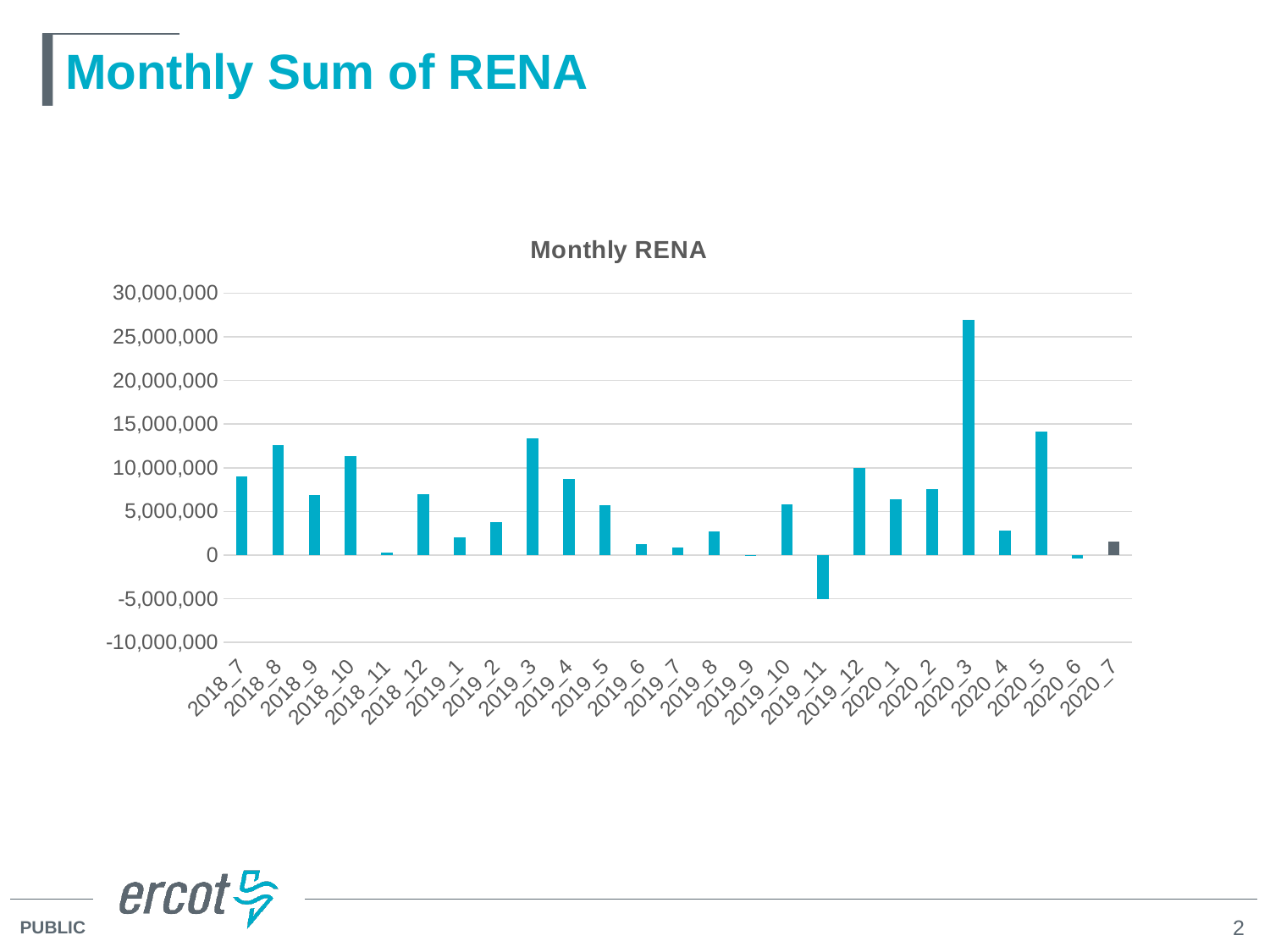
Is the value for 2019_6 greater or less than 5,000,000? less Which is larger, the value for 2020_5 or the value for 2020_4? 2020_5 What kind of chart is shown on the slide? bar chart How many months (categories) are plotted on the x axis? 25 Which month has the lowest value? 2019_11 Is the value for 2019_11 greater or less than 0? less What is the title of the chart? Monthly RENA What is the first month shown on the x axis? 2018_7 Which is larger, the value for 2019_3 or the value for 2019_2? 2019_3 Is the value for 2018_8 greater or less than 10,000,000? greater Which month has the highest value? 2020_3